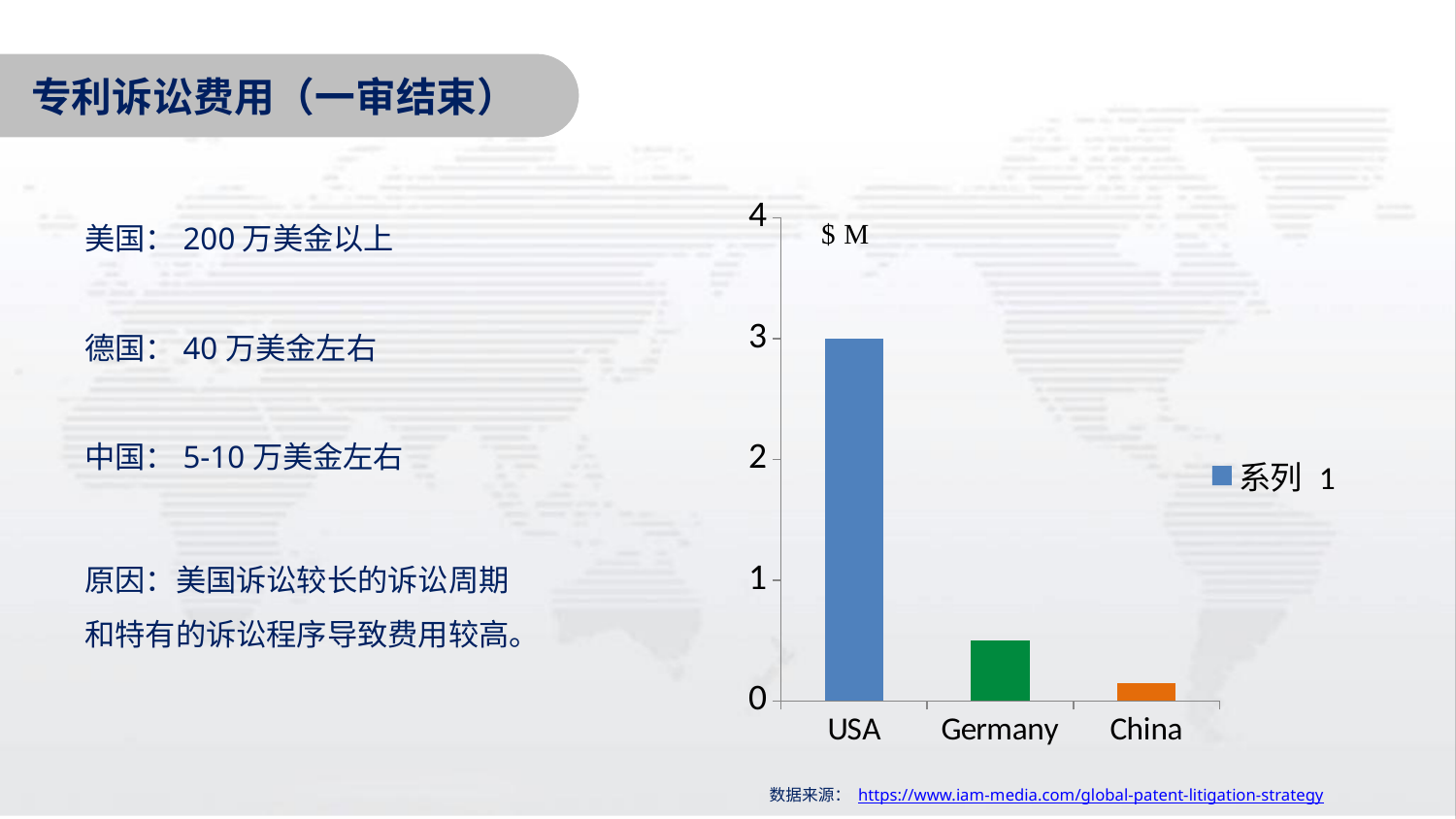
Is the value for Germany greater or less than 1? less Is the value for USA greater or less than 2? greater How many series does the chart legend list? 1 What value does the USA bar reach on the y axis? 3 Do the bar values rise or fall from USA to China along the x axis? fall What unit label is shown at the top of the chart's y axis? $ M Which country has the highest bar in the chart? USA Is the value for China greater or less than 1? less What type of chart is shown on the slide? bar chart How many countries are shown on the x axis of the chart? 3 Which country has the lowest bar in the chart? China Which has a larger value, Germany or China? Germany